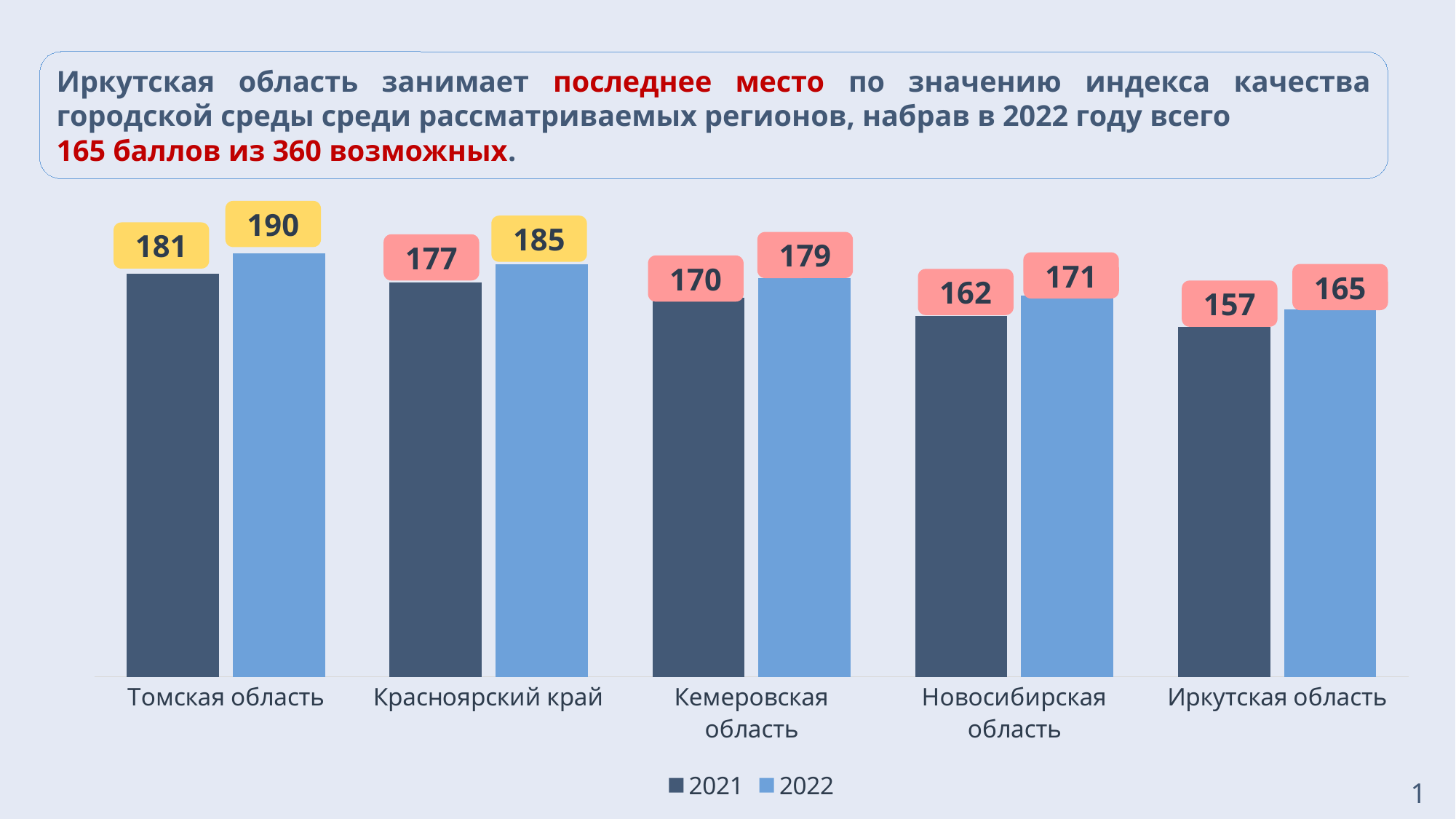
Do the 2022 values rise or fall from left to right across the regions? fall How many regions are shown on the x axis? 5 Which region has the lowest 2021 value? Иркутская область How many series does the legend list? 2 What is the difference between the 2022 values for Томская область and Иркутская область? 25 What kind of chart is shown on the slide? bar chart Which is larger: the 2021 value for Красноярский край or the 2022 value for Кемеровская область? 2022 value for Кемеровская область What is the 2021 value for Кемеровская область? 170 Which region has the highest 2022 value? Томская область What is the difference between the 2022 and 2021 values for Новосибирская область? 9 What is the 2022 value for Томская область? 190 What is the 2021 value for Иркутская область? 157